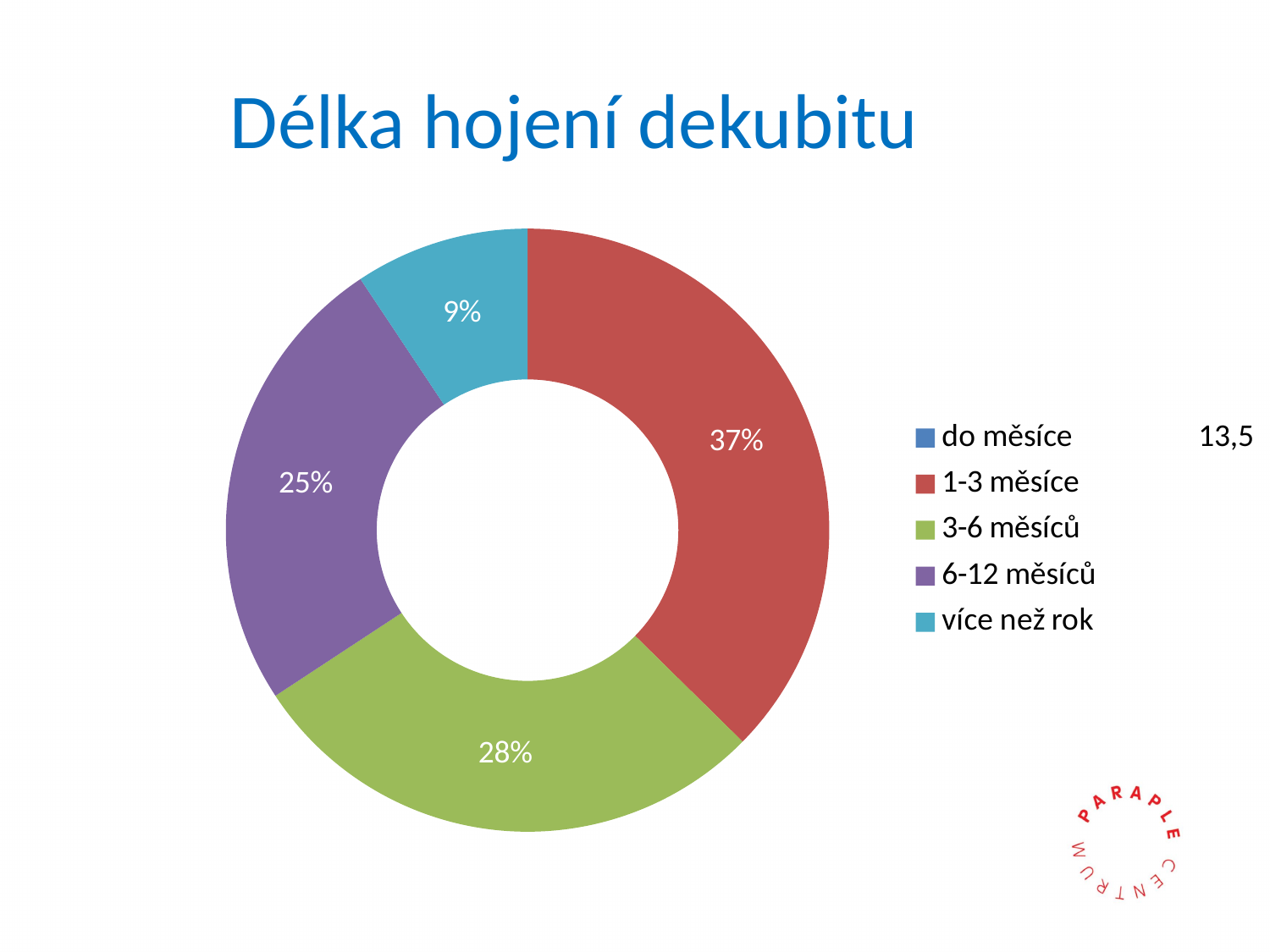
What is the difference in percentage points between the 1-3 měsíce slice and the více než rok slice? 28 What percentage is shown for the více než rok slice? 9% What percentage is shown for the 6-12 měsíců slice? 25% Among the labelled slices, which category has the smallest share? více než rok What colour represents the 6-12 měsíců category? Purple Which slice is larger: 3-6 měsíců or 6-12 měsíců? 3-6 měsíců What is the title of the chart? Délka hojení dekubitu What percentage is shown for the 3-6 měsíců slice? 28% How many categories does the legend list? 5 What type of chart is shown on the slide? Doughnut (pie) chart What percentage is shown for the 1-3 měsíce slice? 37% Which category has the largest share of the chart? 1-3 měsíce